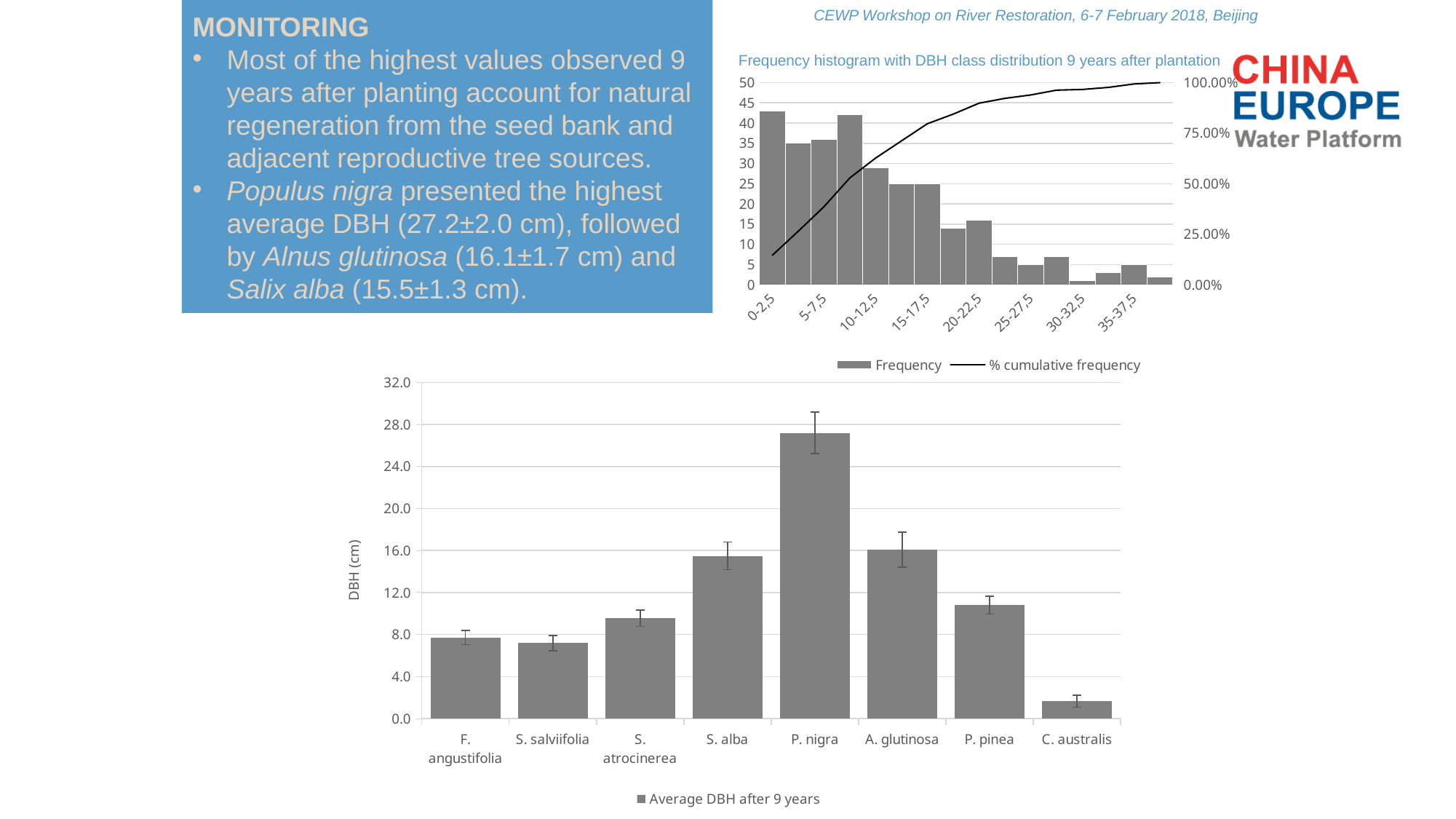
In the bottom chart (Average DBH after 9 years), is the value for P. pinea greater or less than 12.0? less In the bottom chart (Average DBH after 9 years), is the value for P. nigra greater or less than 24.0? greater What kind of chart is the bottom chart (Average DBH after 9 years)? bar chart In the bottom chart (Average DBH after 9 years), how many species are shown on the x axis? 8 In the bottom chart (Average DBH after 9 years), is the value for C. australis greater or less than 4.0? less What is the y-axis label of the bottom chart (Average DBH after 9 years)? DBH (cm) In the top-right chart (Frequency histogram with DBH class distribution 9 years after plantation), does the % cumulative frequency line rise or fall along the x axis? rise In the bottom chart (Average DBH after 9 years), which species has the lowest average DBH? C. australis In the top-right chart (Frequency histogram with DBH class distribution 9 years after plantation), how many series does the legend list? 2 In the bottom chart (Average DBH after 9 years), which species has the highest average DBH? P. nigra In the bottom chart (Average DBH after 9 years), which is larger, the value for P. pinea or the value for S. atrocinerea? P. pinea